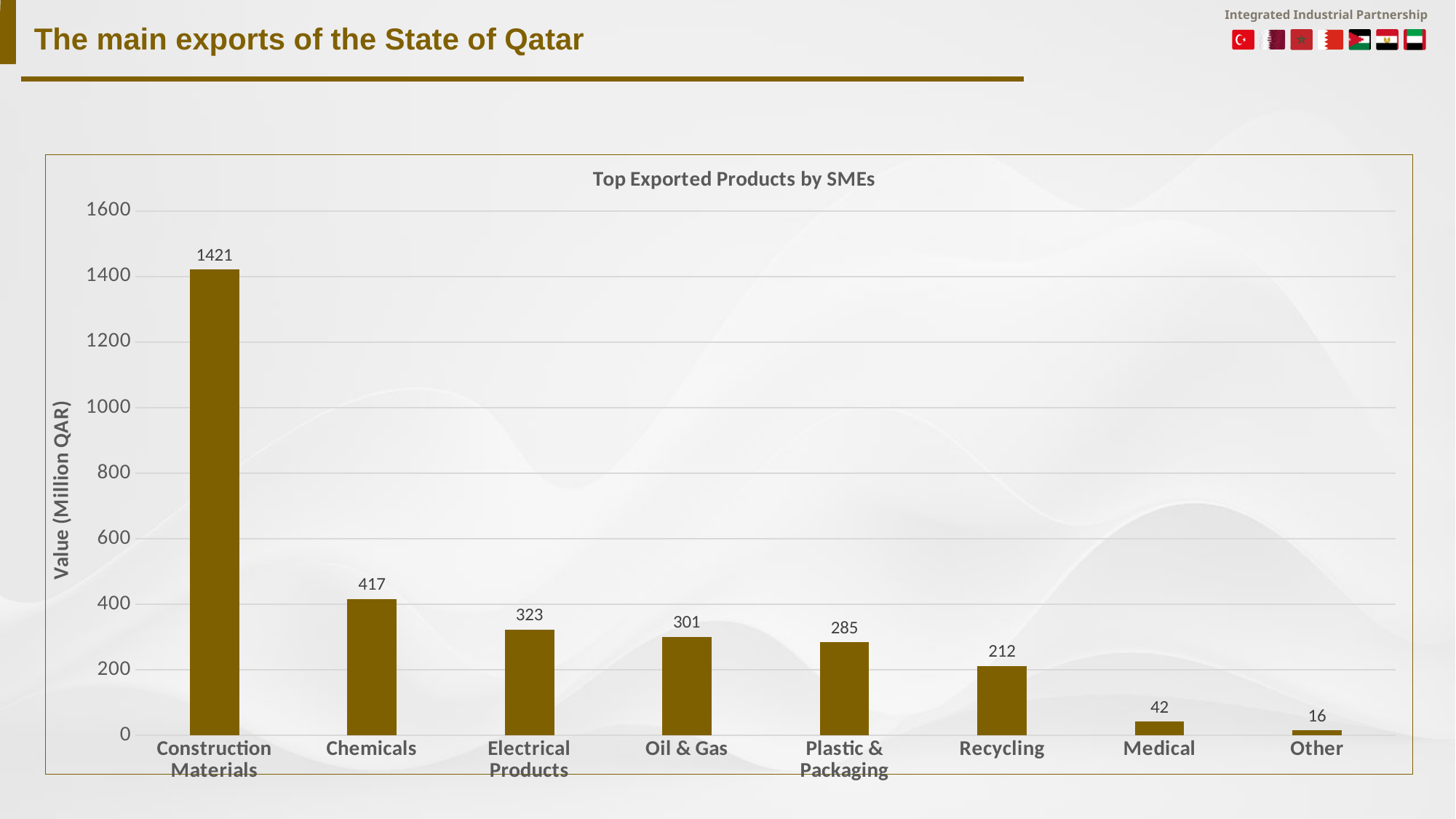
What is the difference between the values for Chemicals and Electrical Products? 94 What is the value for Construction Materials? 1421 What is the title of the chart? Top Exported Products by SMEs Which is larger, the value for Oil & Gas or the value for Plastic & Packaging? Oil & Gas Is the value for Electrical Products greater or less than 400? less Which category has the lowest value? Other Which category has the highest value? Construction Materials What is the value for Recycling? 212 What is the value for Medical? 42 What is the value for Chemicals? 417 What kind of chart is shown on the slide? bar chart How many categories are shown on the x axis? 8